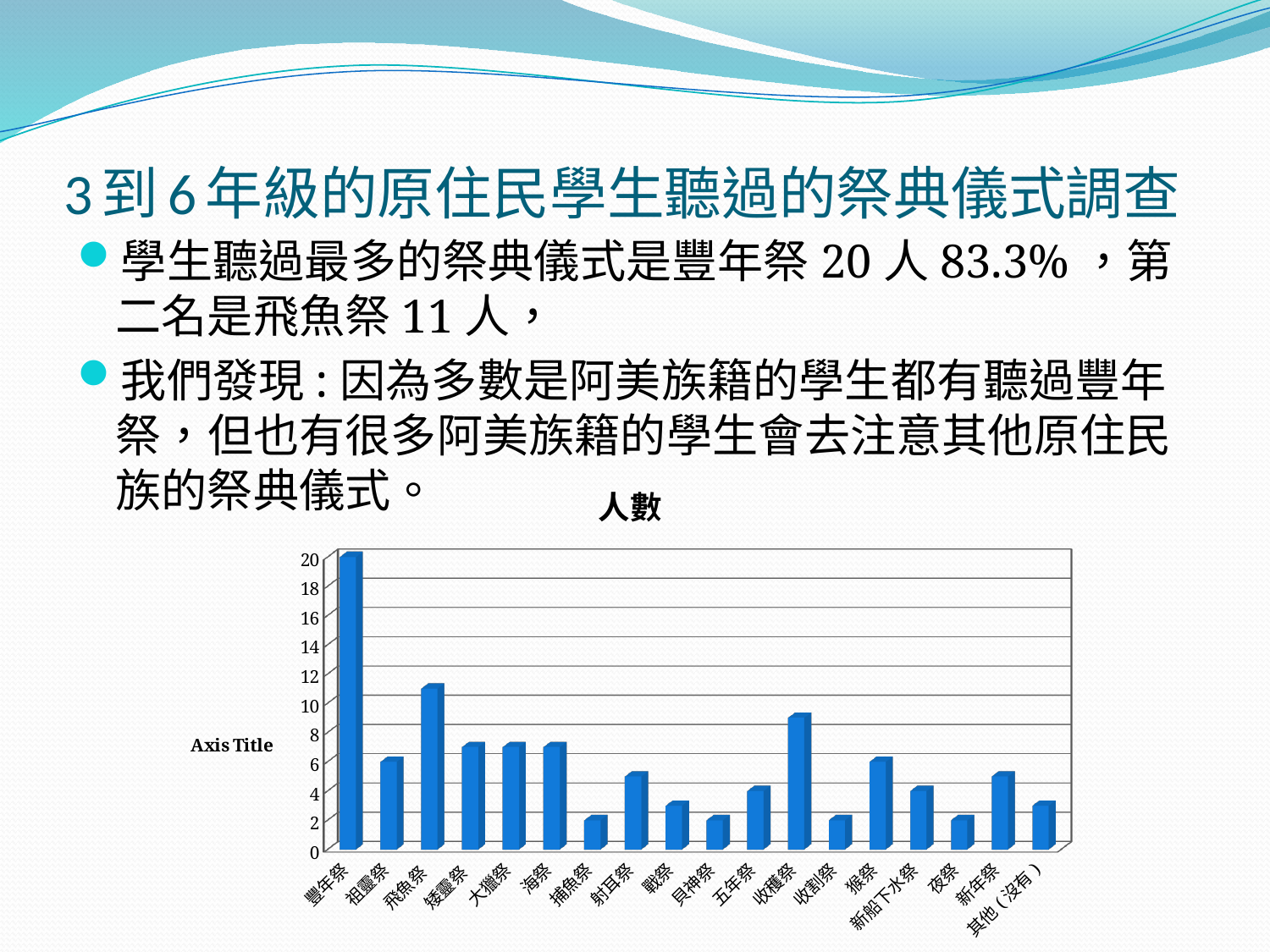
How many categories are shown on the x axis of the chart? 18 Which category has the highest value in the chart? 豐年祭 Is the value for 飛魚祭 greater or less than 10? greater What kind of chart is shown on the slide? bar chart What is the difference between the values for 豐年祭 and 祖靈祭? 14 What is the title of the chart? 人數 What is the value for 豐年祭? 20 What is the value for 夜祭? 2 What is the value for 五年祭? 4 Is the value for 射耳祭 greater or less than 4? greater What is the value for 祖靈祭? 6 Which is larger, the value for 收穫祭 or the value for 猴祭? 收穫祭